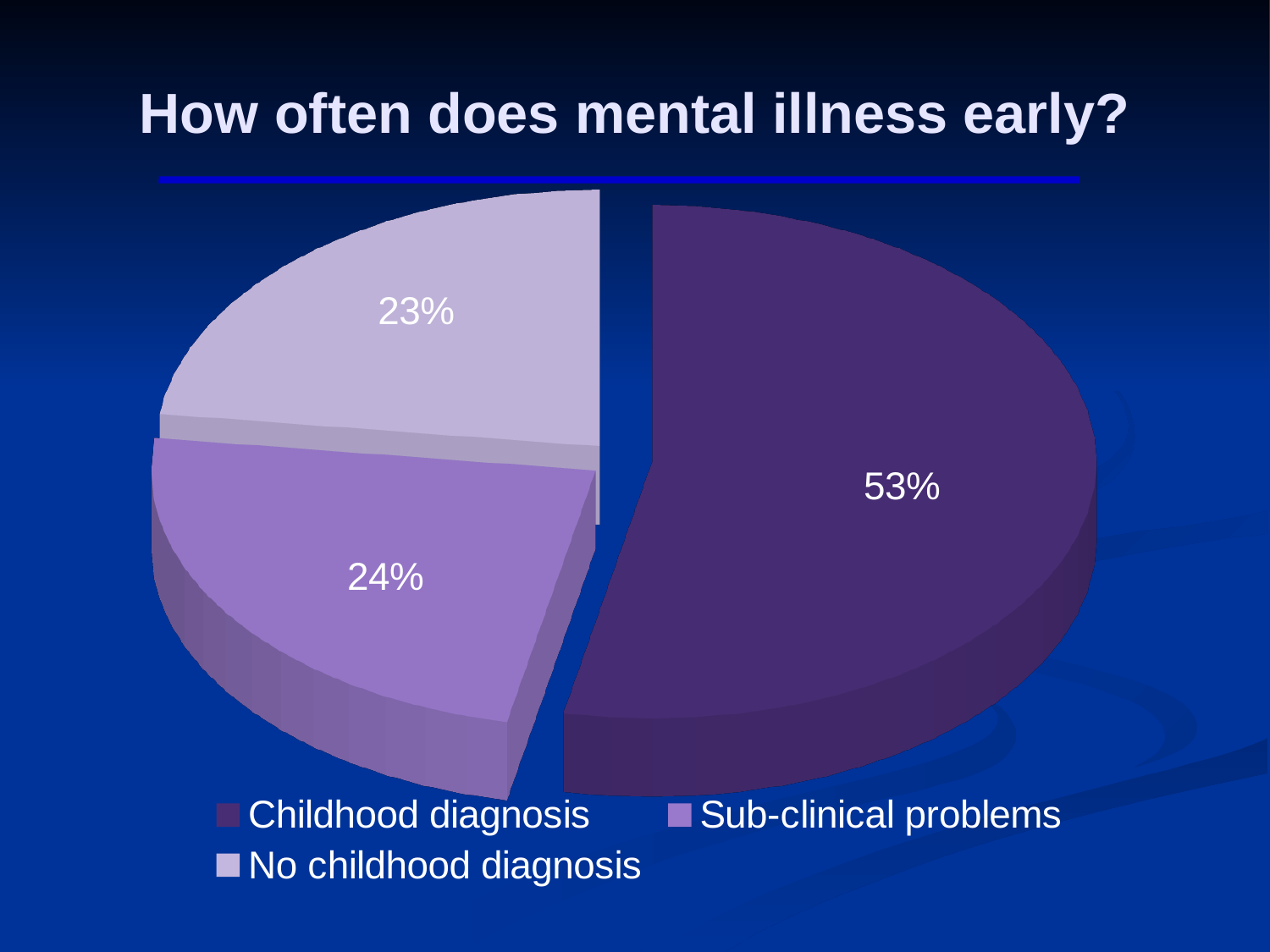
Which is larger, the Sub-clinical problems slice or the No childhood diagnosis slice? Sub-clinical problems What kind of chart is shown on the slide? Pie chart What is the title of the slide? How often does mental illness early? What share of the pie is labelled No childhood diagnosis? 23% What share of the pie is labelled Childhood diagnosis? 53% Which category has the smallest slice of the pie? No childhood diagnosis What is the difference in percentage points between the Childhood diagnosis slice and the Sub-clinical problems slice? 29 How many entries does the legend list? 3 What share of the pie is labelled Sub-clinical problems? 24% Which legend entry is shown in the lightest colour? No childhood diagnosis Which category has the largest slice of the pie? Childhood diagnosis How many slices does the pie chart have? 3